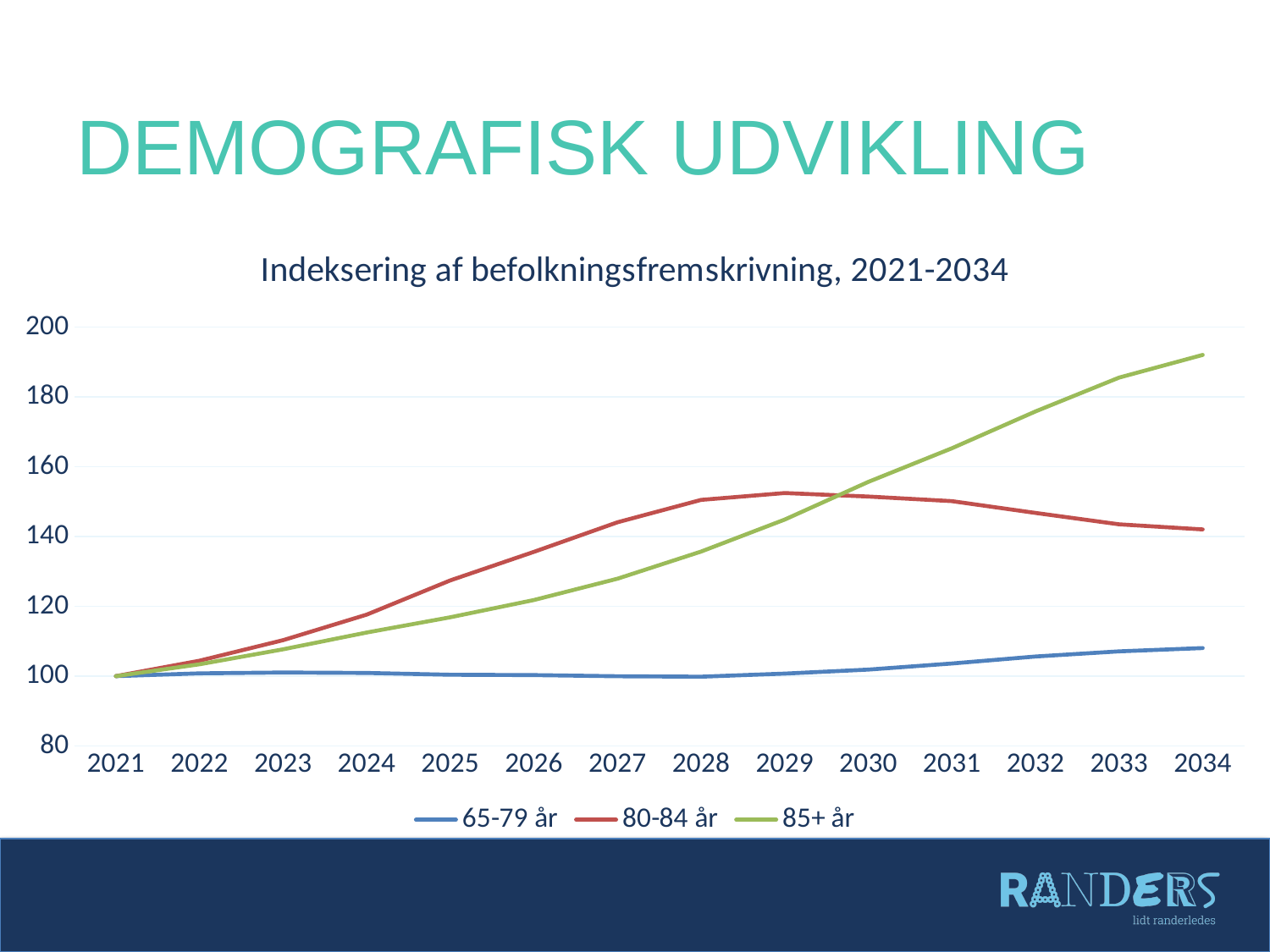
Is the value for 85+ år in 2034 greater or less than 180? greater In 2026, which series has the larger value, 80-84 år or 85+ år? 80-84 år How many series does the legend list? 3 Is the value for 65-79 år in 2034 greater or less than 120? less Which series has the lowest value in 2034? 65-79 år Is the value for 80-84 år in 2029 greater or less than 140? greater What is the value for 85+ år in 2021? 100 Does the value for 80-84 år rise or fall between 2029 and 2034? fall How many years are shown on the x axis? 14 Which series has the highest value in 2034? 85+ år What kind of chart is shown on the slide? line chart What is the title of the chart? Indeksering af befolkningsfremskrivning, 2021-2034